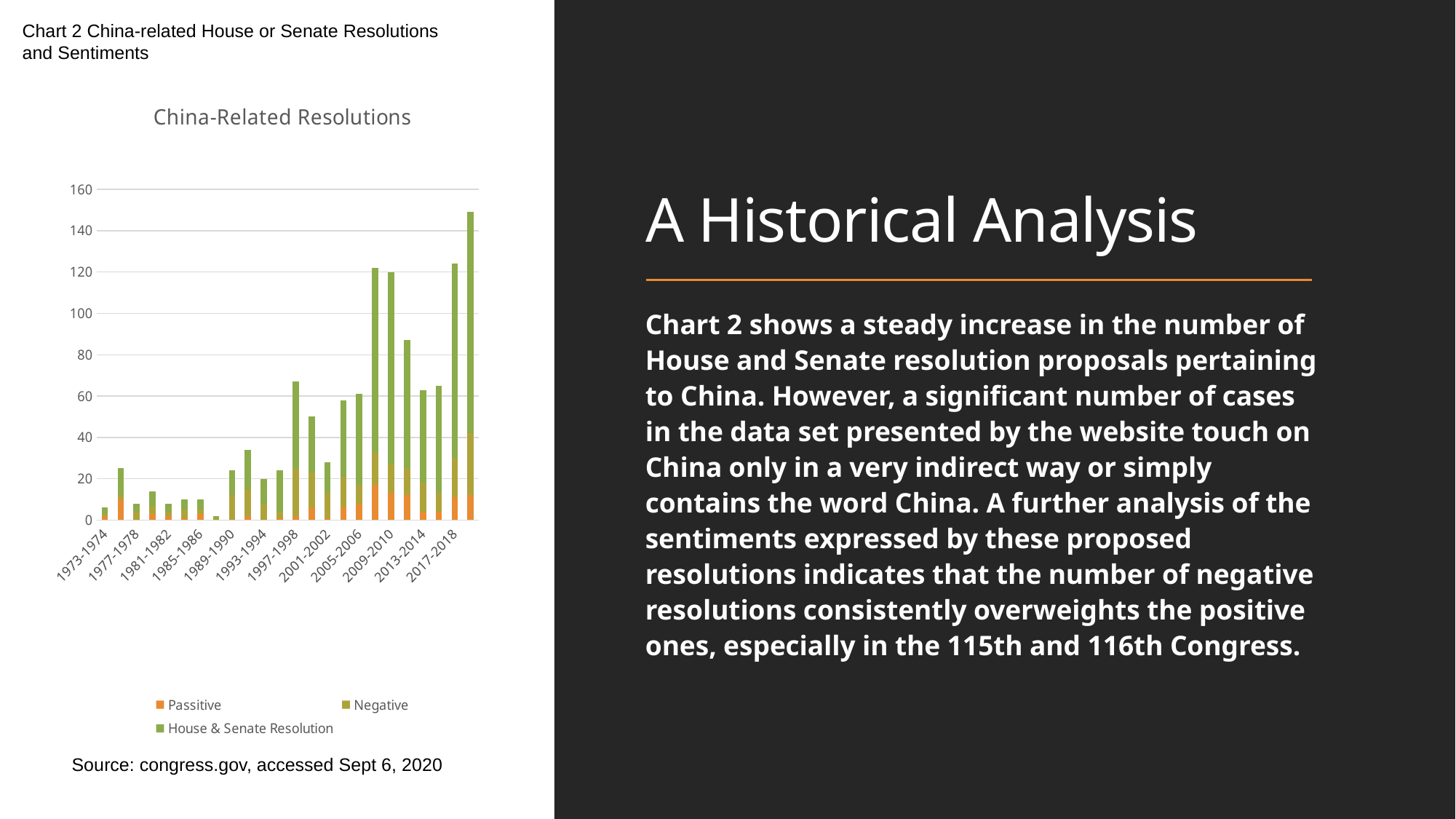
Which series are listed in the chart's legend? Passitive, Negative, House & Senate Resolution Is the total value for 1973-1974 greater or less than 20? less Is the total value for 2009-2010 greater or less than 100? greater Is the total value for 2017-2018 greater or less than 100? greater Do the totals generally rise or fall from the earliest to the latest period along the x axis? Rise What kind of chart is shown on the slide? Stacked bar chart How many series does the legend of the chart list? 3 What is the title of the chart? China-Related Resolutions Which has a larger total, 2009-2010 or 1997-1998? 2009-2010 Which has a larger total, 1977-1978 or 1985-1986? 1985-1986